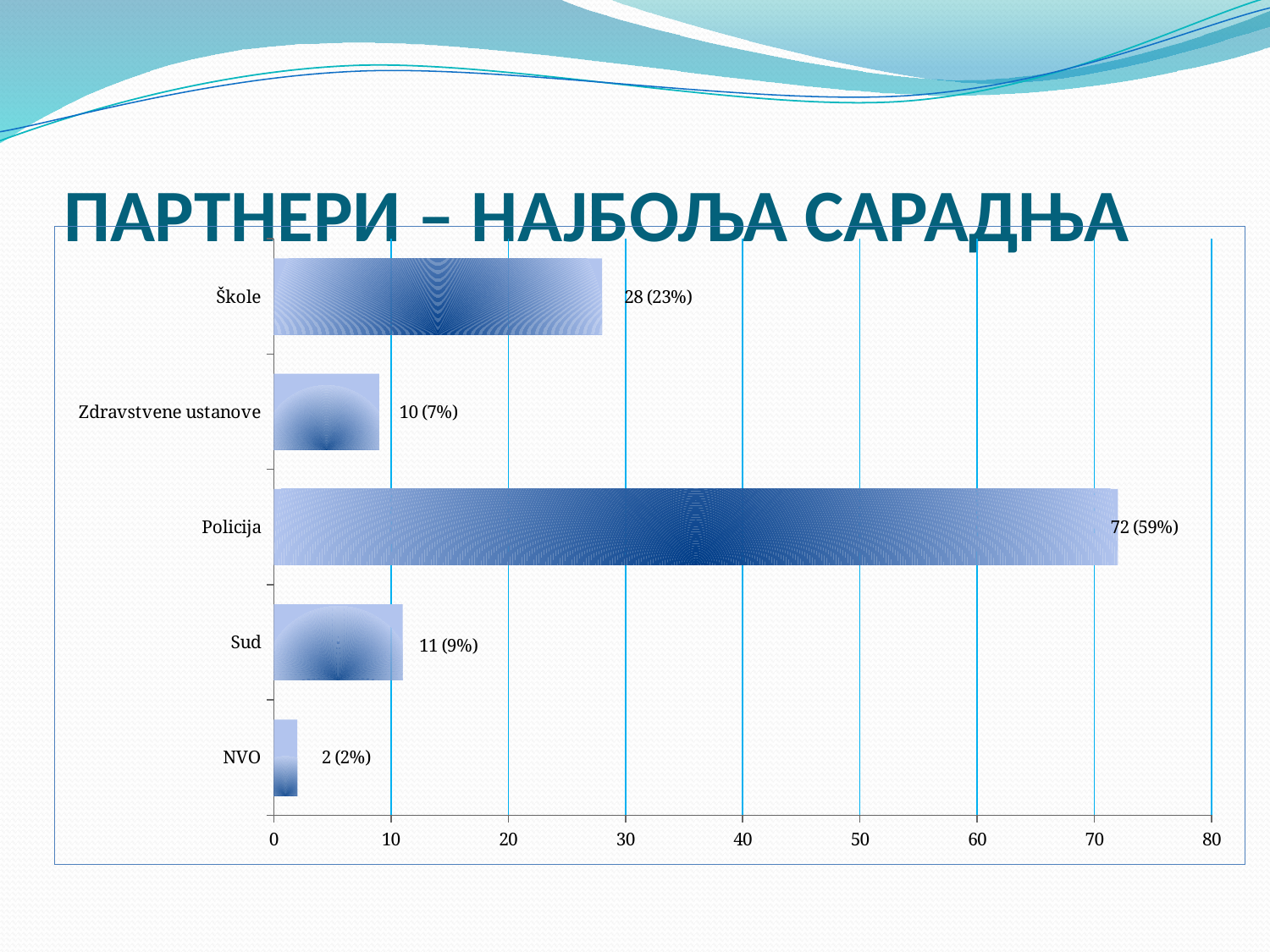
What value is shown for Škole? 28 (23%) What value is shown for Zdravstvene ustanove? 10 (7%) What value is shown for Policija? 72 (59%) Which category has the lowest value? NVO What is the title of the slide? ПАРТНЕРИ – НАЈБОЉА САРАДЊА What value is shown for NVO? 2 (2%) Which is larger, the value for Sud or the value for Zdravstvene ustanove? Sud How many categories are shown in the chart? 5 What kind of chart is shown on the slide? bar chart Is the value for Škole greater or less than 20? greater Which category has the highest value? Policija What is the difference between the values for Policija and Škole? 44